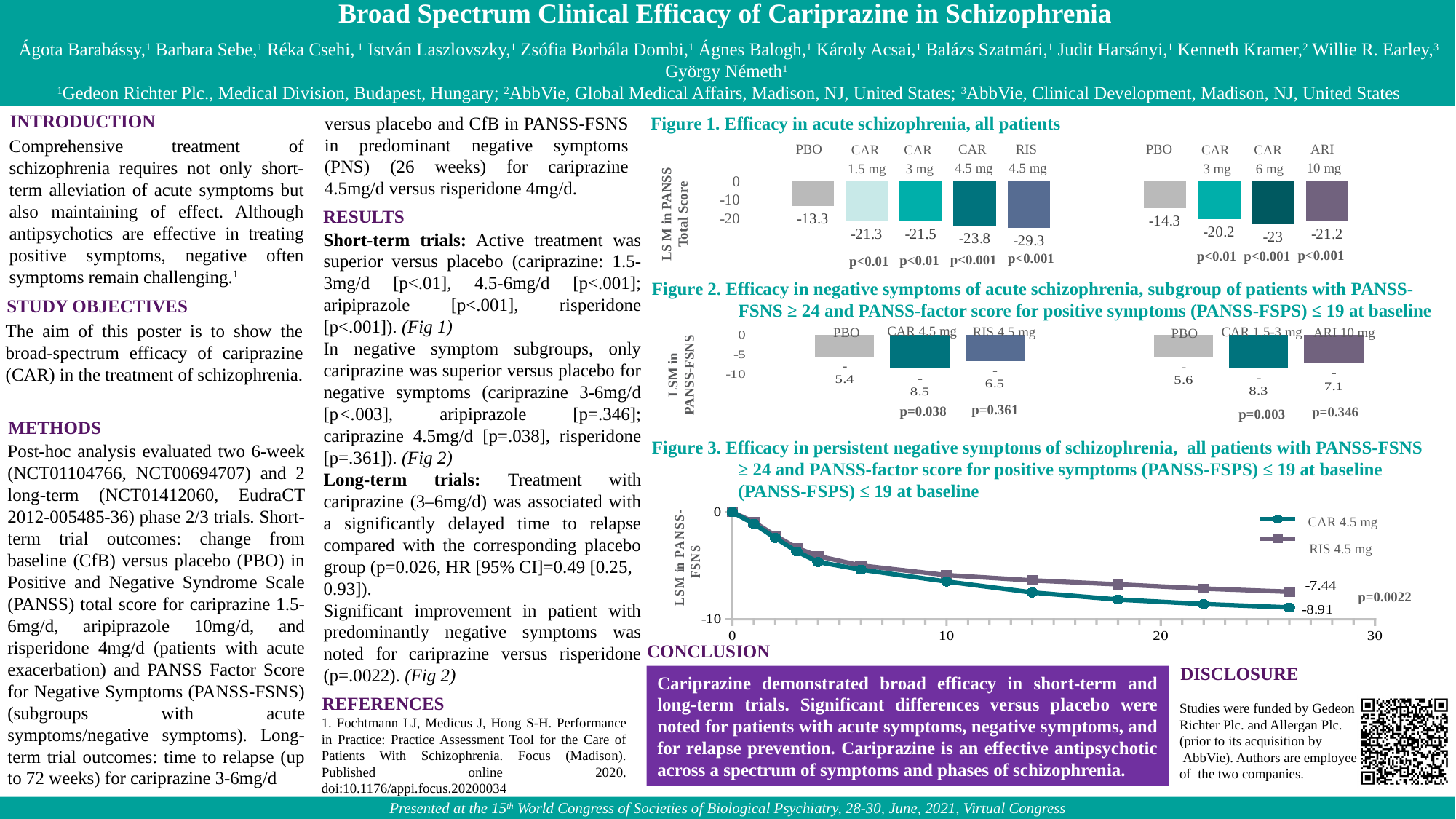
In the left chart of Figure 2, what is the value for CAR 4.5 mg? -8.5 How many treatment groups are shown in the left chart of Figure 1? 5 In the right chart of Figure 1, which treatment has the smallest (least negative) change in PANSS total score? PBO What kind of chart is Figure 3? Line chart In the left chart of Figure 2, which group has the larger reduction in PANSS-FSNS, CAR 4.5 mg or RIS 4.5 mg? CAR 4.5 mg How many series does the legend of Figure 3 list? 2 In the left chart of Figure 1, what is the value for RIS 4.5 mg? -29.3 In Figure 3, what is the final value for CAR 4.5 mg? -8.91 In the left chart of Figure 1, what is the difference between the values for CAR 4.5 mg and PBO? 10.5 In the right chart of Figure 1, what is the value for CAR 6 mg? -23 In the left chart of Figure 1, what is the LS mean change in PANSS total score for PBO? -13.3 In the right chart of Figure 2, what is the value for ARI 10 mg? -7.1